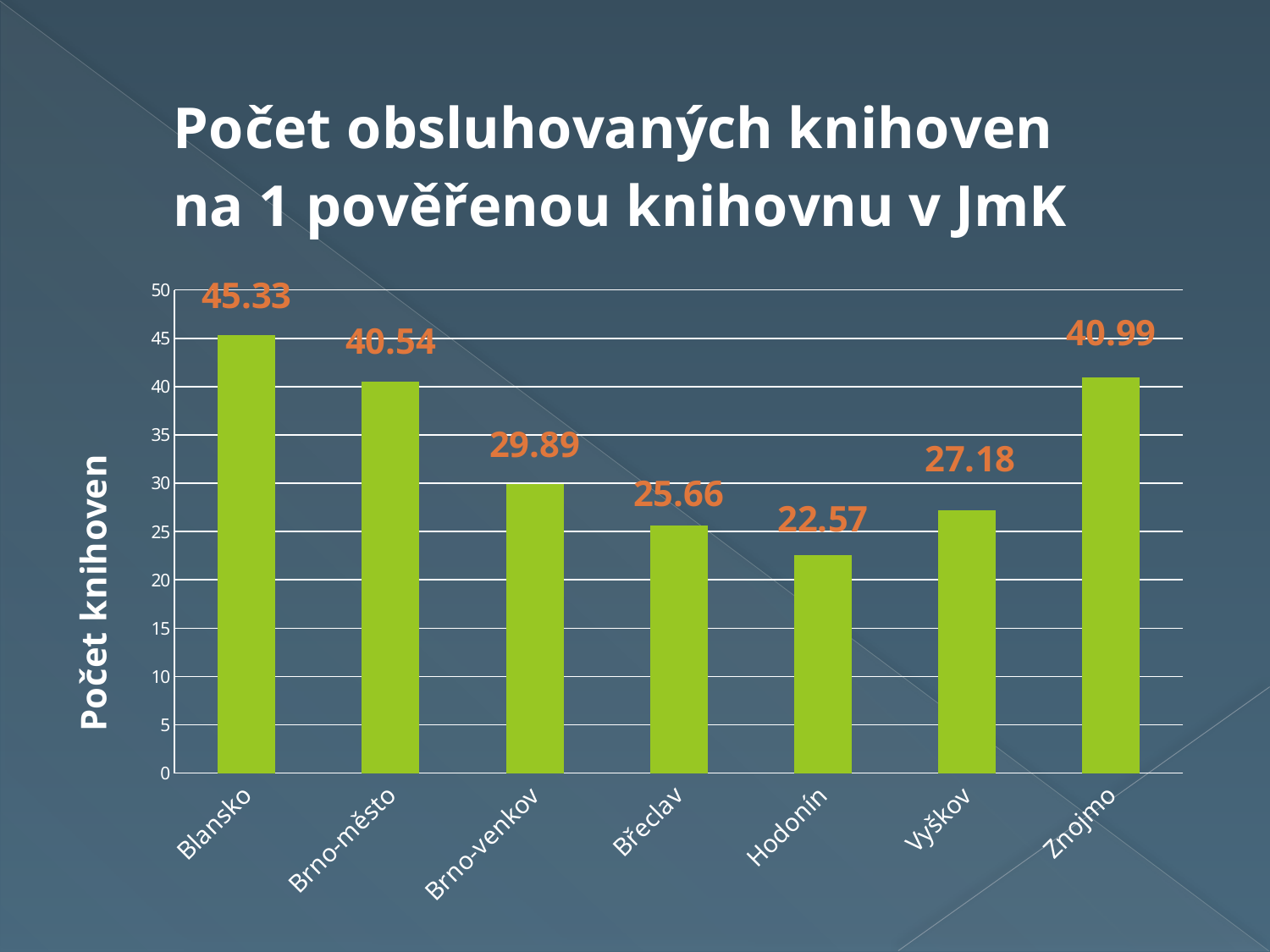
Which is larger, the value for Břeclav or the value for Vyškov? Vyškov Which category has the lowest value? Hodonín How many categories are shown on the x axis? 7 What is the difference between the values for Blansko and Hodonín? 22.76 What kind of chart is shown on the slide? bar chart What is the difference between the values for Brno-město and Brno-venkov? 10.65 What is the value for Blansko? 45.33 Which category has the highest value? Blansko What is the label of the vertical axis? Počet knihoven What is the value for Znojmo? 40.99 What is the value for Hodonín? 22.57 What is the value for Vyškov? 27.18